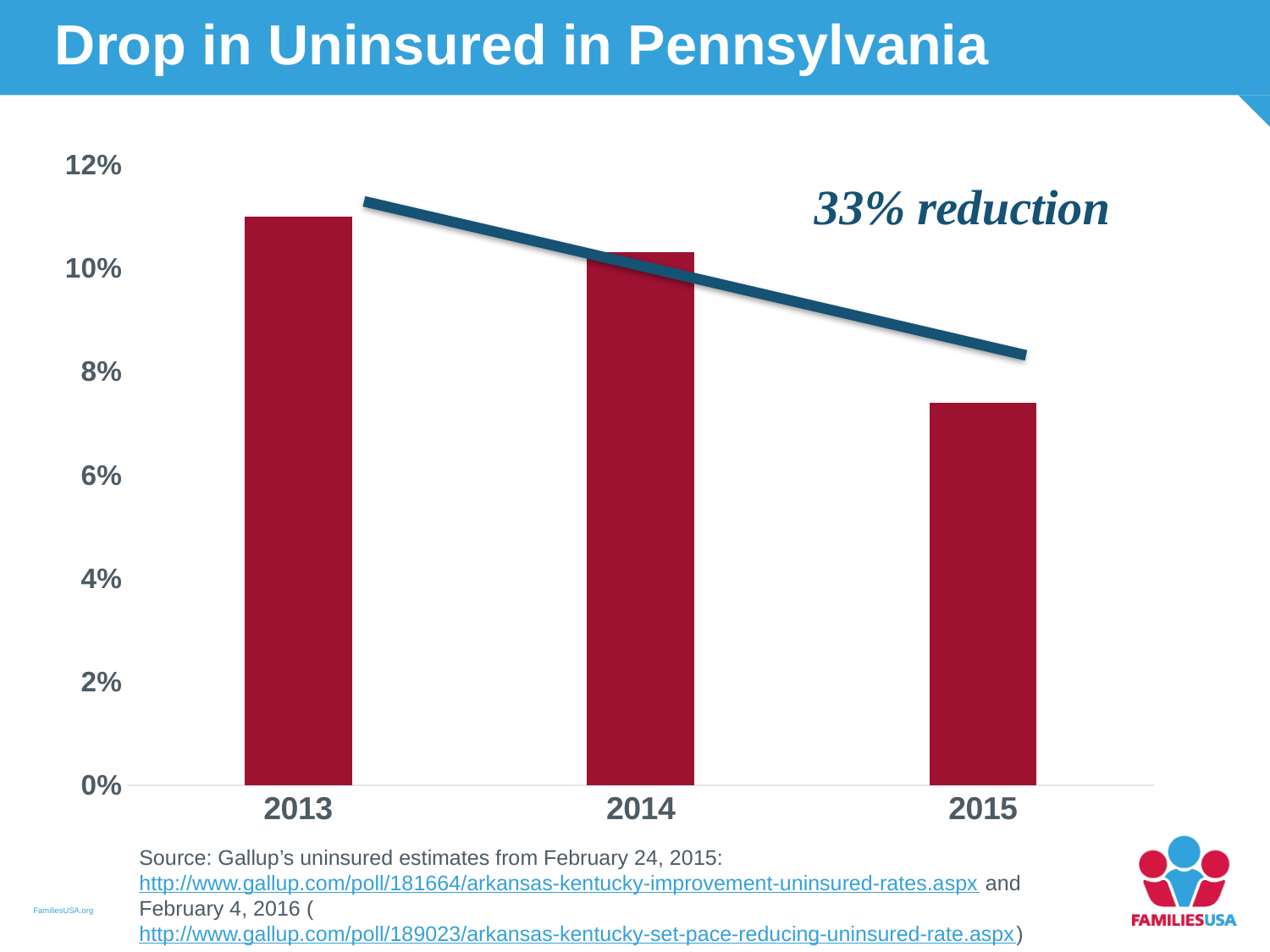
Which is larger, the value for 2014 or the value for 2015? 2014 Which is larger, the value for 2013 or the value for 2015? 2013 What kind of chart is shown on the slide? bar chart Which year has the highest uninsured rate in the chart? 2013 How many years are shown on the x axis of the chart? 3 What reduction is stated in the annotation next to the trend line on the chart? 33% reduction Do the values rise or fall from 2013 to 2015? fall Is the value for 2015 greater or less than 8%? less Which year has the lowest uninsured rate in the chart? 2015 Is the value for 2014 greater or less than 8%? greater What is the title of the slide containing the chart? Drop in Uninsured in Pennsylvania Is the value for 2013 greater or less than 10%? greater